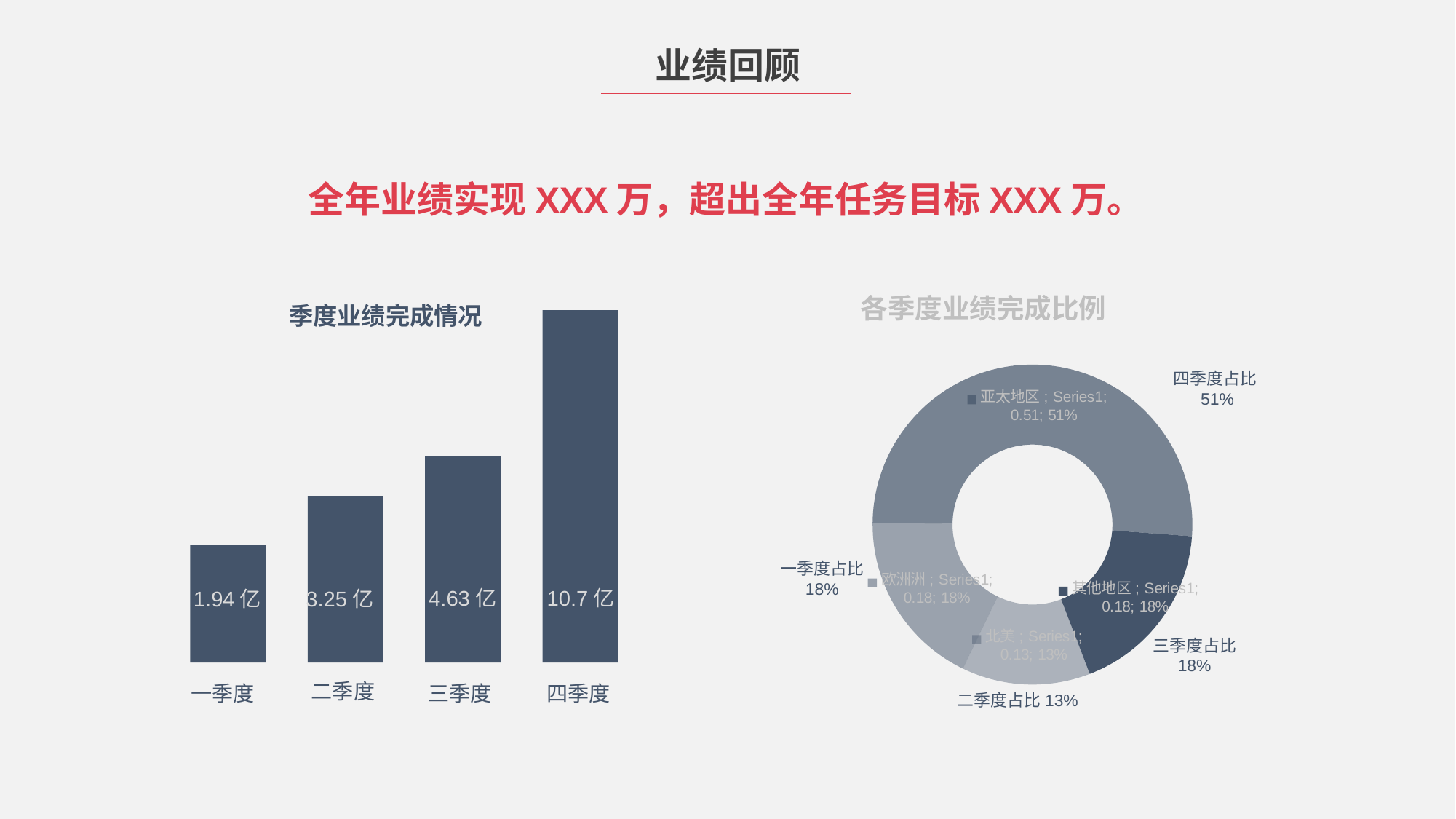
In the bar chart titled 季度业绩完成情况, what is the difference between the values for 三季度 and 一季度? 2.69 亿 What kind of chart is the one on the left of the slide, titled 季度业绩完成情况? bar chart In the bar chart titled 季度业绩完成情况, which is larger, the value for 二季度 or 三季度? 三季度 In the doughnut chart titled 各季度业绩完成比例, what share is labelled 二季度占比? 13% In the bar chart titled 季度业绩完成情况, which quarter has the lowest value? 一季度 In the bar chart titled 季度业绩完成情况, how many bars are plotted? 4 What is the title of the chart on the right of the slide? 各季度业绩完成比例 In the bar chart titled 季度业绩完成情况, what is the value for 四季度? 10.7 亿 In the bar chart titled 季度业绩完成情况, do the values rise or fall from 一季度 to 四季度? rise In the doughnut chart titled 各季度业绩完成比例, what share is labelled 四季度占比? 51% In the bar chart titled 季度业绩完成情况, which quarter has the highest value? 四季度 In the bar chart titled 季度业绩完成情况, what is the value for 二季度? 3.25 亿